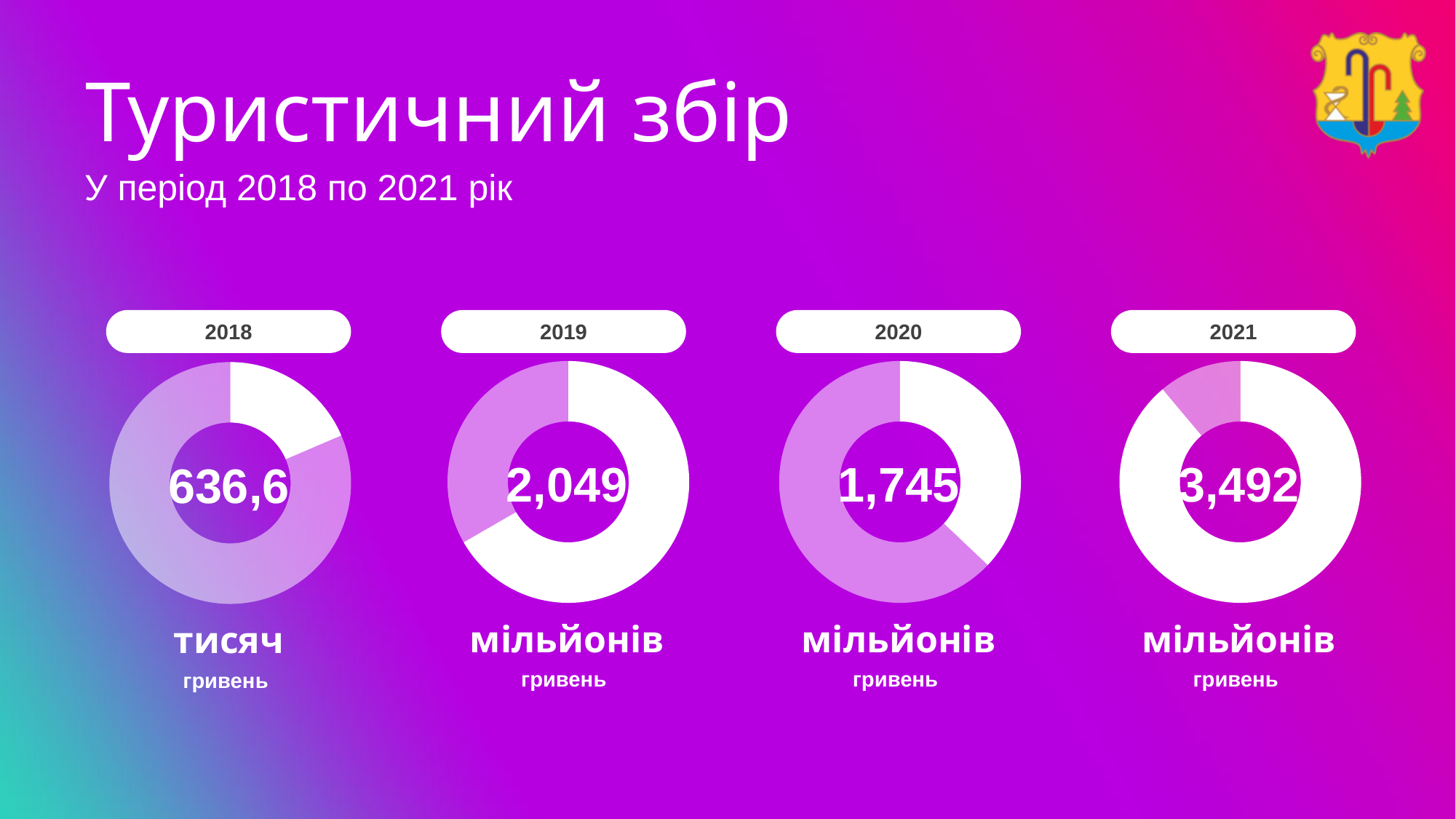
What value is shown in the centre of the 2018 donut chart? 636,6 Which year has the lowest tourist tax value shown on the slide? 2018 What unit is given under the 2018 donut chart? тисяч гривень Which year has the highest tourist tax value shown on the slide? 2021 What value is shown in the centre of the 2019 donut chart? 2,049 What is the difference between the 2019 value (2,049 million) and the 2020 value (1,745 million)? 0,304 мільйонів гривень Which is larger, the value for 2019 or the value for 2020? 2019 What is the title of the slide? Туристичний збір What value is shown in the centre of the 2021 donut chart? 3,492 What value is shown in the centre of the 2020 donut chart? 1,745 What kind of charts are used on the slide? Donut charts How many donut charts are on the slide? 4